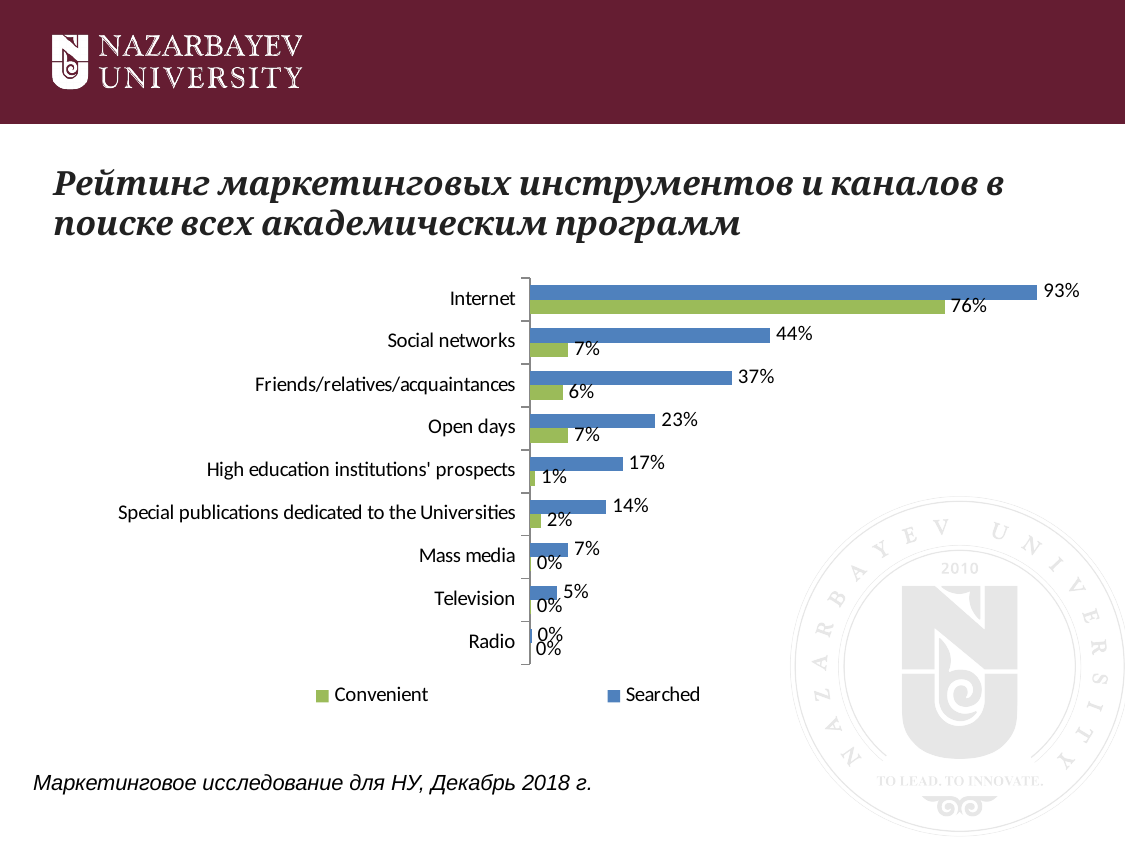
Which is larger: the Searched value for Friends/relatives/acquaintances or the Searched value for Open days? Friends/relatives/acquaintances Which colour represents the Convenient series? Green What kind of chart is shown on the slide? Bar chart Which category has the lowest Searched value? Radio How many series does the legend list? 2 What is the Searched value for Internet? 93% What is the Convenient value for Internet? 76% How many categories are shown on the chart? 9 Which category has the highest Searched value? Internet What is the difference between the Searched and Convenient values for Social networks? 37% What is the Convenient value for Open days? 7% What is the Searched value for Social networks? 44%